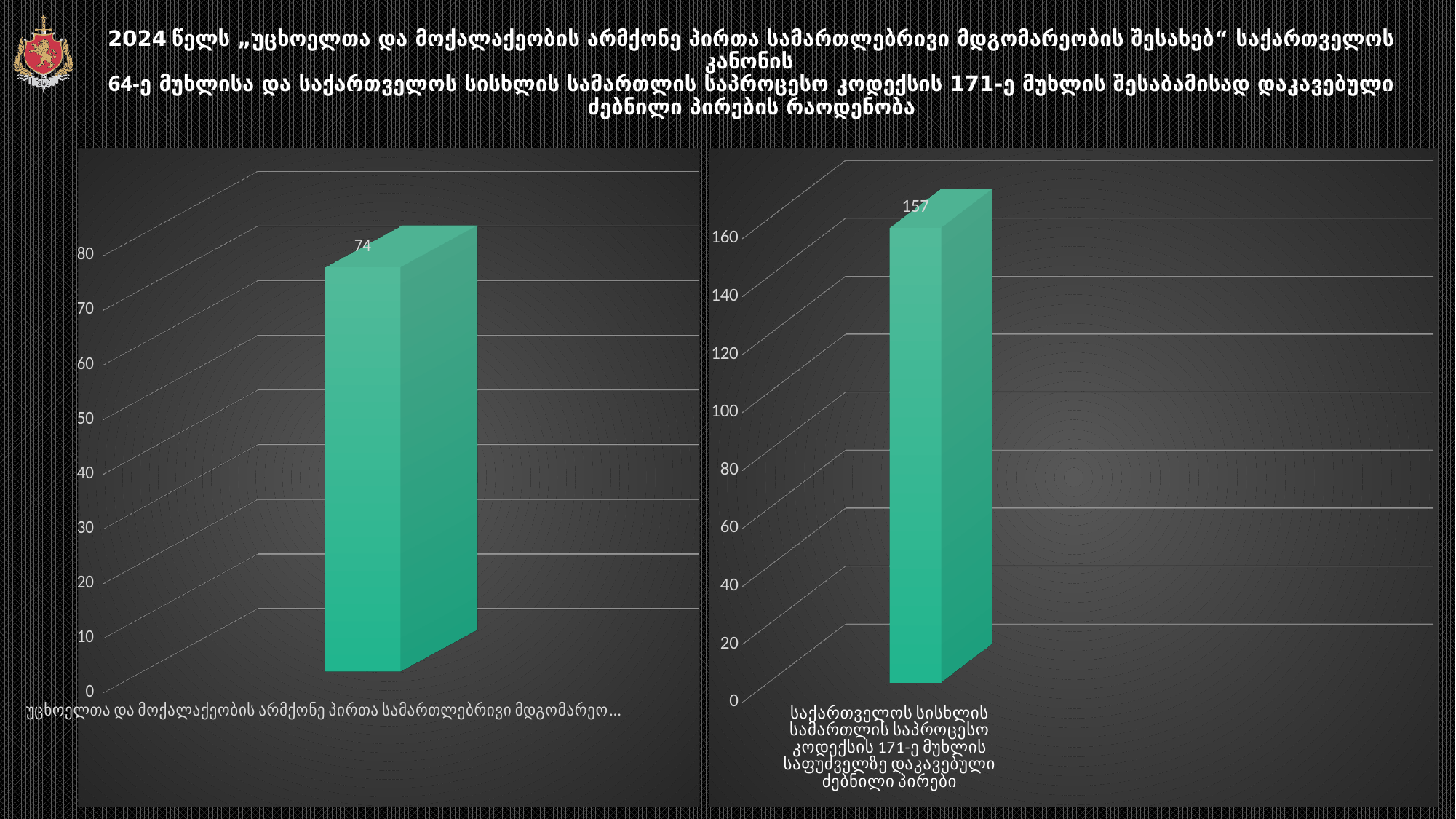
Which is larger: the value on the left chart or the value on the right chart? The right chart (157) What is the highest tick value shown on the vertical axis of the right chart? 160 What is the difference between the value on the right chart (157) and the value on the left chart (74)? 83 On the right chart, is the value of the bar greater or less than 140? greater On the left chart, what value is shown on the bar? 74 On the left chart, is the value of the bar greater or less than 70? greater How many bars are plotted on the right chart? 1 On the right chart, what value is shown on the bar for persons detained under Article 171 of the Criminal Procedure Code of Georgia? 157 What is the highest tick value shown on the vertical axis of the left chart? 80 How many bars are plotted on the left chart? 1 What kind of chart is the right chart? Bar chart